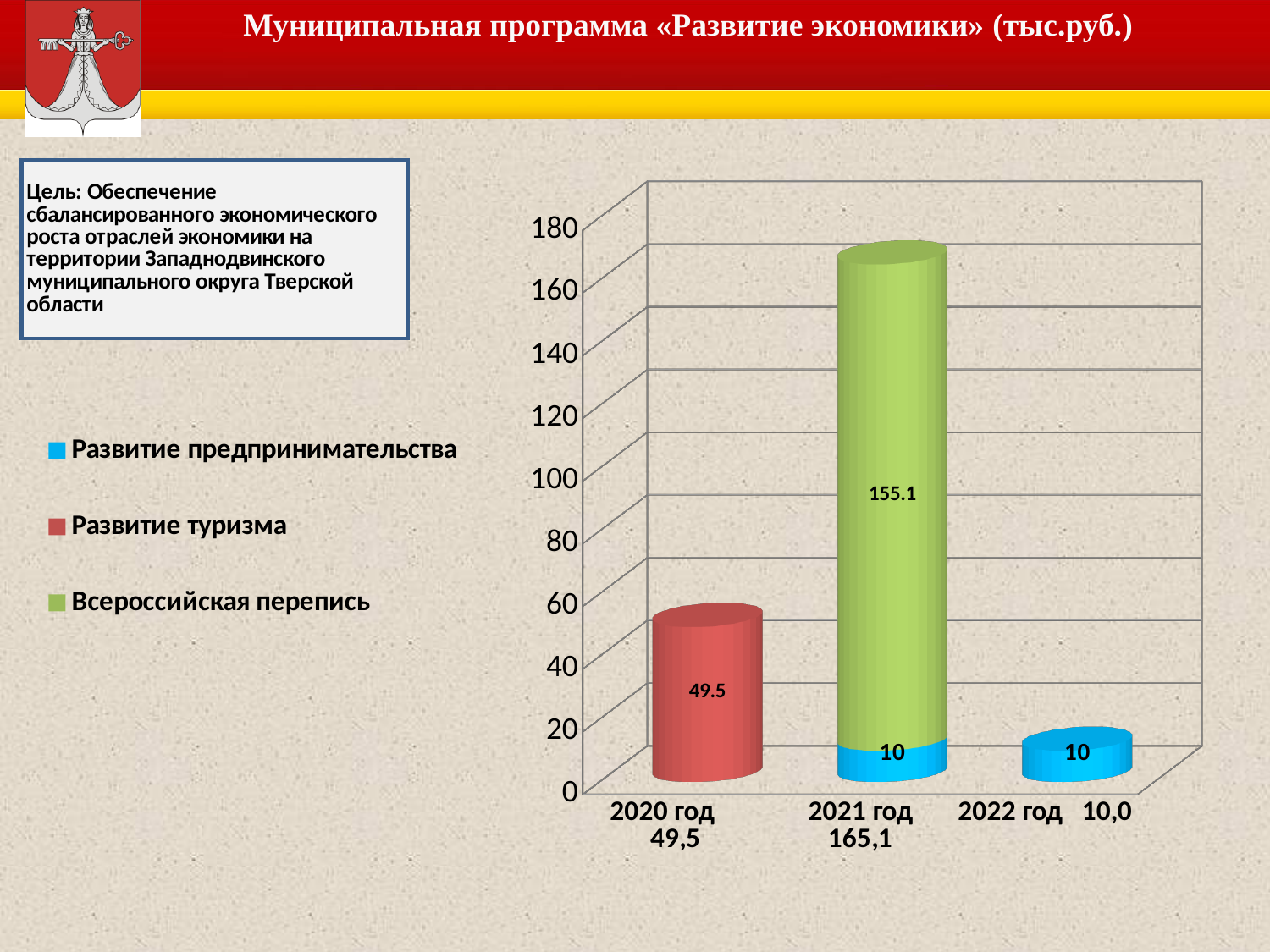
What is the value of Развитие предпринимательства for 2022 год? 10 Which series is shown in green in the legend? Всероссийская перепись What is the value of Развитие туризма for 2020 год? 49.5 How many series does the legend list? 3 What is the value of Развитие предпринимательства for 2021 год? 10 Which year has the shortest stacked bar? 2022 год What is the difference between the Всероссийская перепись value for 2021 год and the Развитие туризма value for 2020 год? 105.6 How many year categories are shown on the x axis? 3 What is the total of the stacked bar for 2021 год? 165,1 What is the value of Всероссийская перепись for 2021 год? 155.1 Which year has the tallest stacked bar? 2021 год What kind of chart is shown on the slide? bar chart